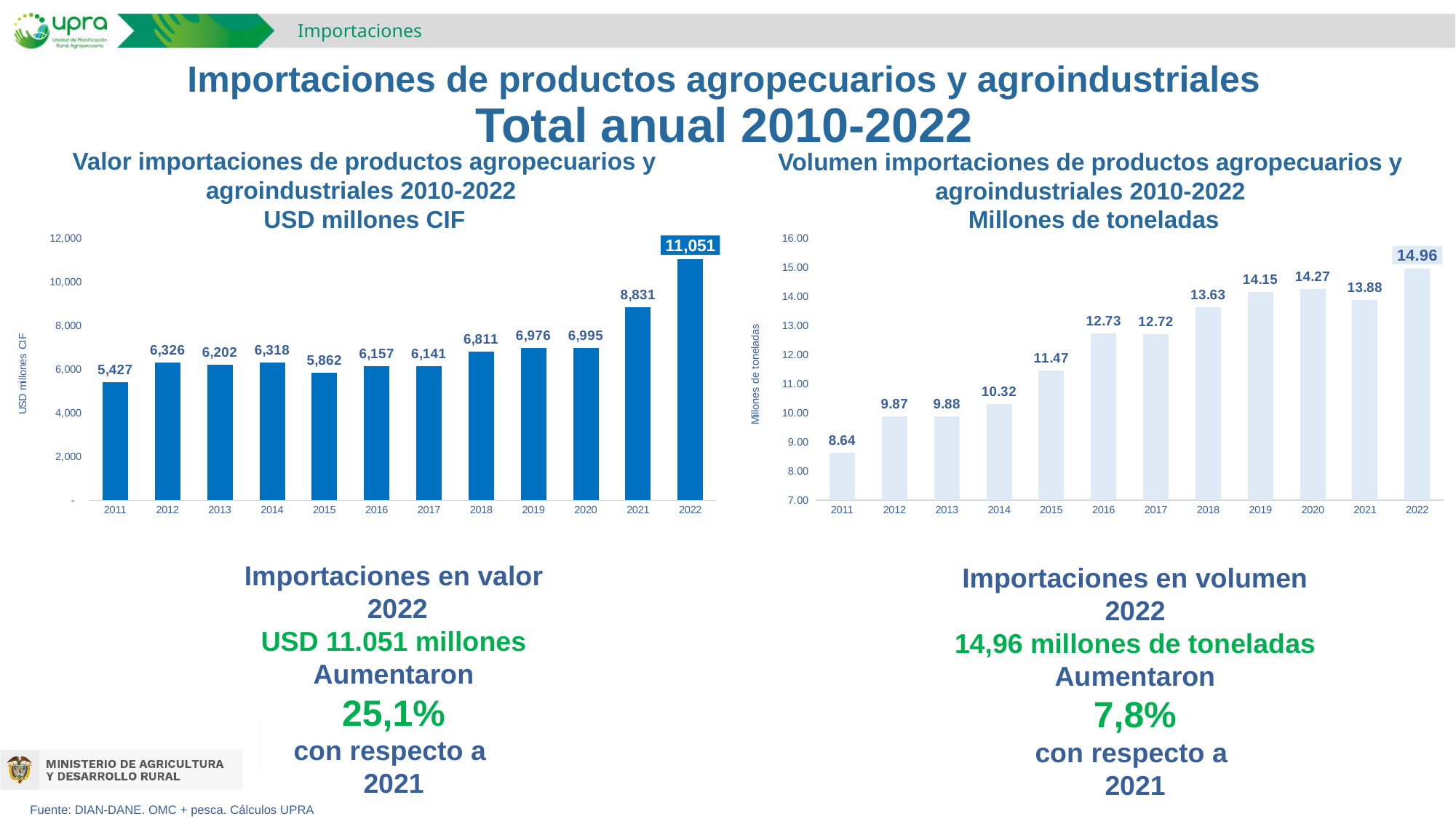
In the right chart (Volumen importaciones, Millones de toneladas), what is the difference between the 2022 and 2021 values? 1.08 In the left chart (Valor importaciones, USD millones CIF), what is the difference between the 2022 and 2021 values? 2,220 How many years are plotted in the left chart (Valor importaciones, USD millones CIF)? 12 In the left chart (Valor importaciones, USD millones CIF), which year has the lowest value? 2011 In the right chart (Volumen importaciones, Millones de toneladas), what is the value for 2018? 13.63 In the left chart (Valor importaciones, USD millones CIF), what is the value for 2015? 5,862 In the left chart (Valor importaciones, USD millones CIF), which year has the highest value? 2022 In the right chart (Volumen importaciones, Millones de toneladas), which year has the lowest value? 2011 What is the y-axis label of the left chart (Valor importaciones)? USD millones CIF In the right chart (Volumen importaciones, Millones de toneladas), which is larger, the value for 2020 or the value for 2021? 2020 In the left chart (Valor importaciones, USD millones CIF), which is larger, the value for 2019 or the value for 2020? 2020 What kind of chart is the right chart (Volumen importaciones, Millones de toneladas)? bar chart